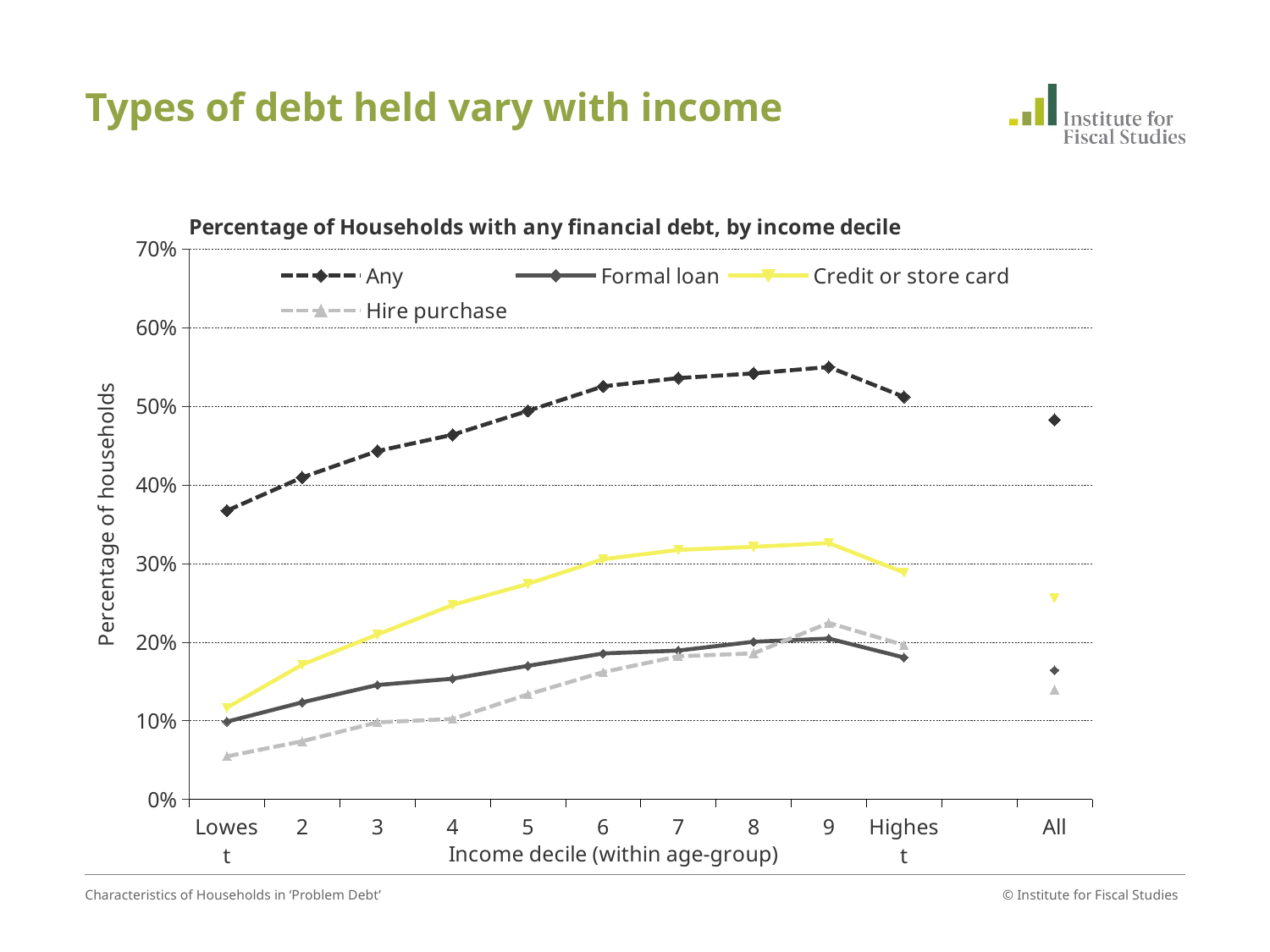
What is the title of the chart? Percentage of Households with any financial debt, by income decile How many categories are shown along the x axis? 11 For the 'Any' series, which income decile has the lowest value? Lowest At the Lowest income decile, which is larger: 'Formal loan' or 'Hire purchase'? Formal loan Is the value for 'Credit or store card' at income decile 9 greater or less than 30%? greater Is the value for 'Hire purchase' at the Lowest income decile greater or less than 10%? less How many series does the legend list? 4 For the 'Hire purchase' series, which income decile has the highest value? 9 Is the value for 'Any' at the Lowest income decile greater or less than 40%? less For the 'Any' series, which income decile has the highest value? 9 What kind of chart is shown on the slide? Line chart Does the 'Credit or store card' series rise or fall from the Lowest decile to decile 9? rise